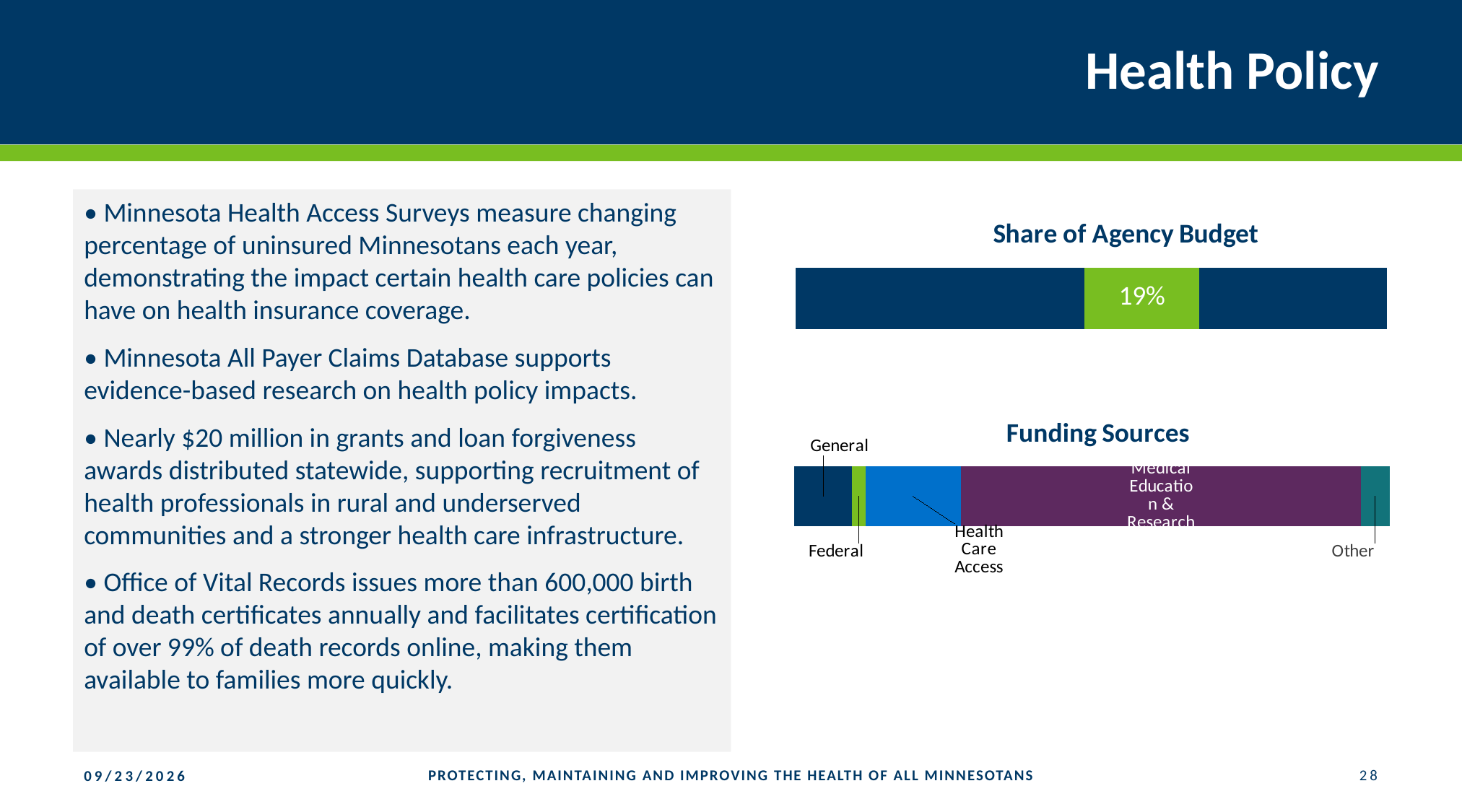
In the Funding Sources chart, which segment is larger, General or Other? General In the Funding Sources chart, which funding source has the largest segment? Medical Education & Research In the Funding Sources chart, which segment is larger, Medical Education & Research or Health Care Access? Medical Education & Research In the Share of Agency Budget chart, what percentage is printed on the highlighted green segment? 19% What is the title of the lower chart on the slide? Funding Sources What kind of chart is the Funding Sources chart? bar chart In the Funding Sources chart, how many labelled funding source segments are shown? 5 In the Funding Sources chart, what colour is the Medical Education & Research segment? purple What kind of chart is the Share of Agency Budget chart? bar chart In the Funding Sources chart, which segment is larger, Health Care Access or Federal? Health Care Access